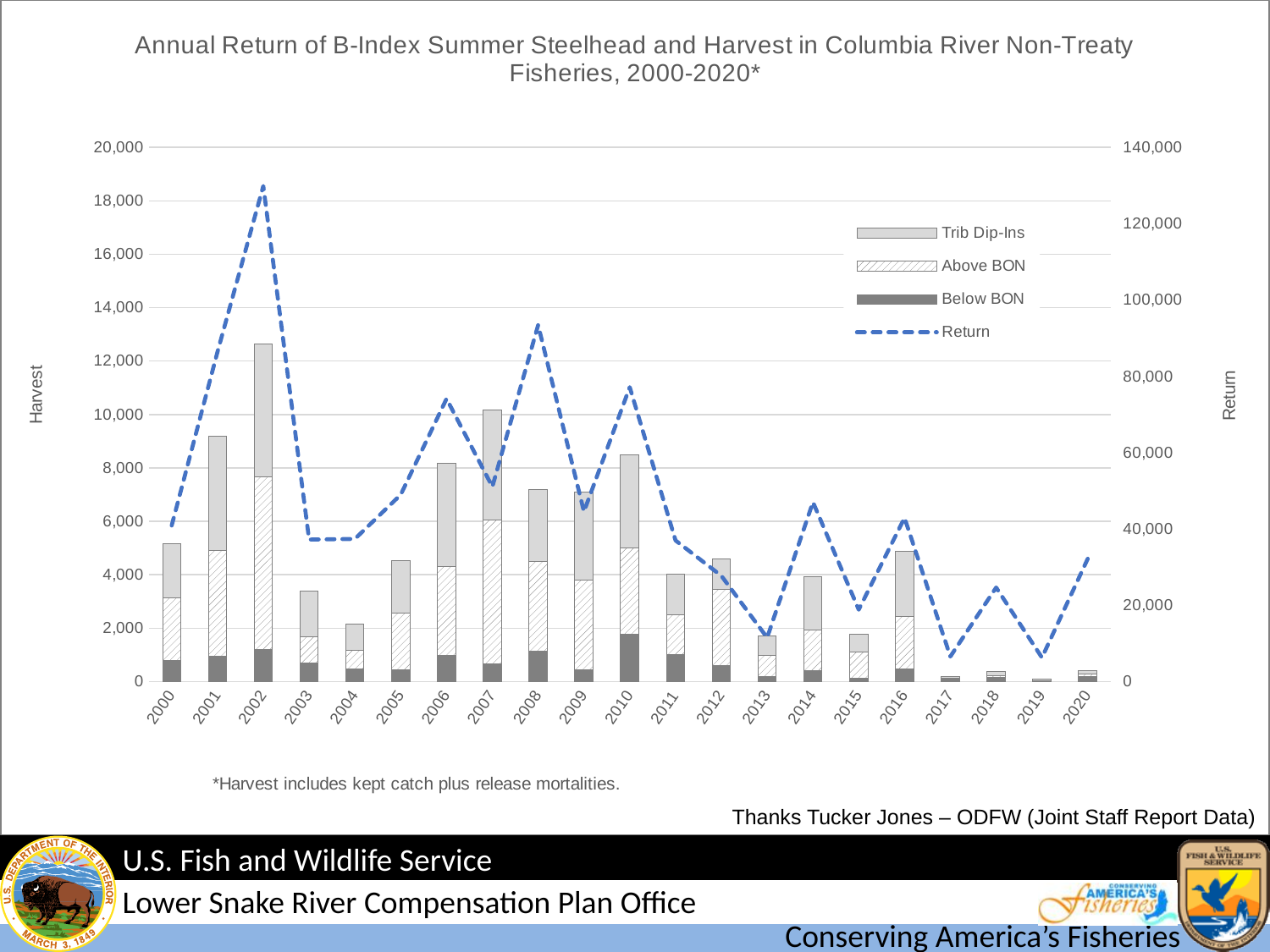
Which year has the higher Return value, 2010 or 2011? 2010 How many series does the legend list? 4 Which year has the larger total harvest, 2006 or 2007? 2007 Is the Return value for 2020 greater or less than 40,000? less Is the total harvest for 2002 greater or less than 12,000? greater Is the total harvest for 2013 greater or less than 2,000? less What is the label of the right-hand vertical axis? Return How many years are shown on the x axis? 21 In which year does the Return line reach its highest point? 2002 Does the Return line rise or fall from 2000 to 2002? rise Which year has the highest total harvest bar? 2002